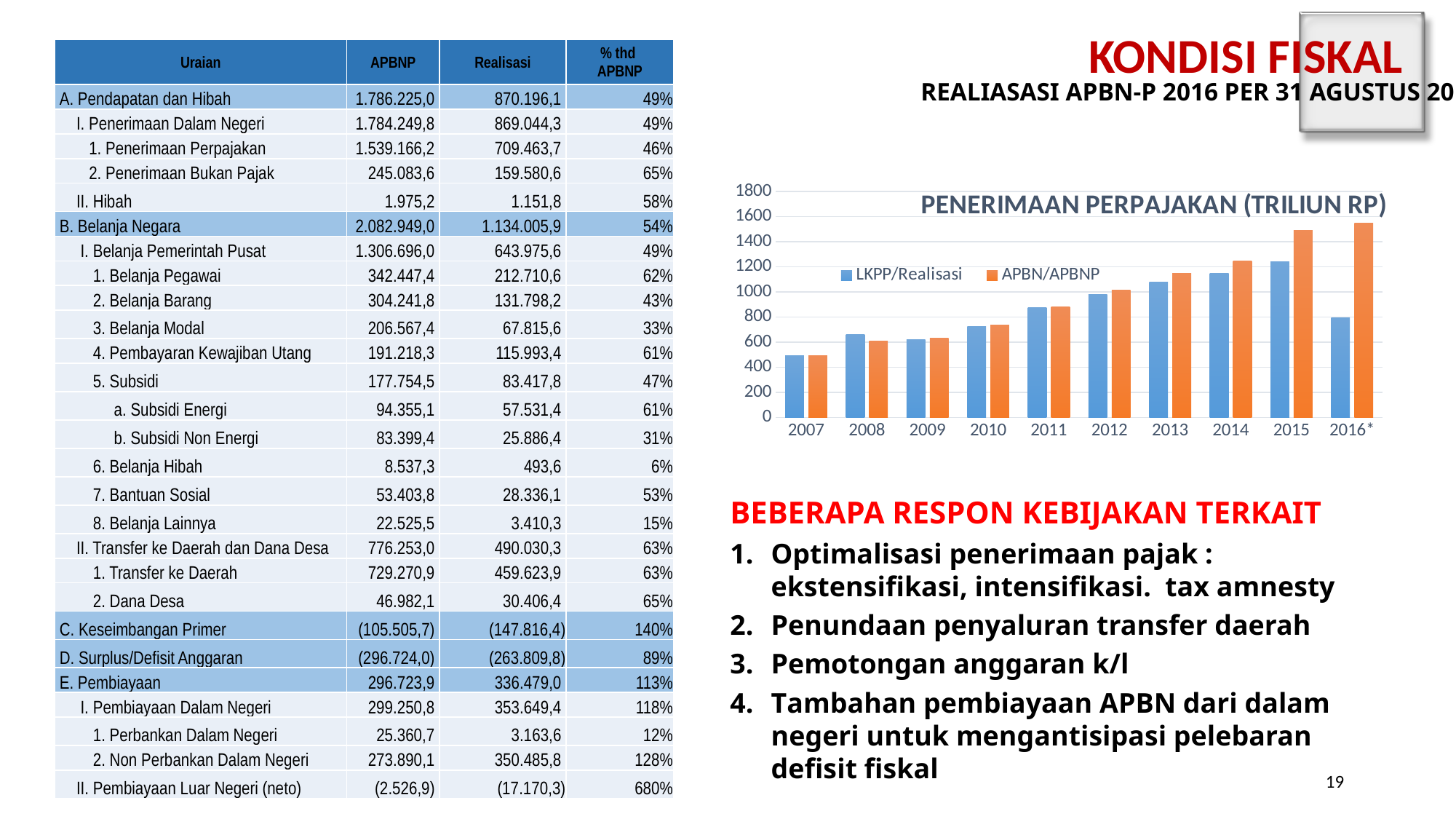
Which is larger: the LKPP/Realisasi value for 2015 or the LKPP/Realisasi value for 2016*? 2015 What is the title of the chart? PENERIMAAN PERPAJAKAN (TRILIUN RP) Which year has the highest APBN/APBNP value in the chart? 2016* Is the LKPP/Realisasi value for 2007 greater or less than 600? less Is the LKPP/Realisasi value for 2016* greater or less than 1000? less Is the APBN/APBNP value for 2016* greater or less than 1400? greater In 2015, which is larger: the LKPP/Realisasi value or the APBN/APBNP value? APBN/APBNP How many years are shown on the x axis of the chart? 10 Which year has the lowest LKPP/Realisasi value in the chart? 2007 What kind of chart is shown on the slide? bar chart Does the APBN/APBNP series generally rise or fall from 2009 to 2016*? rise How many series does the legend of the chart list? 2